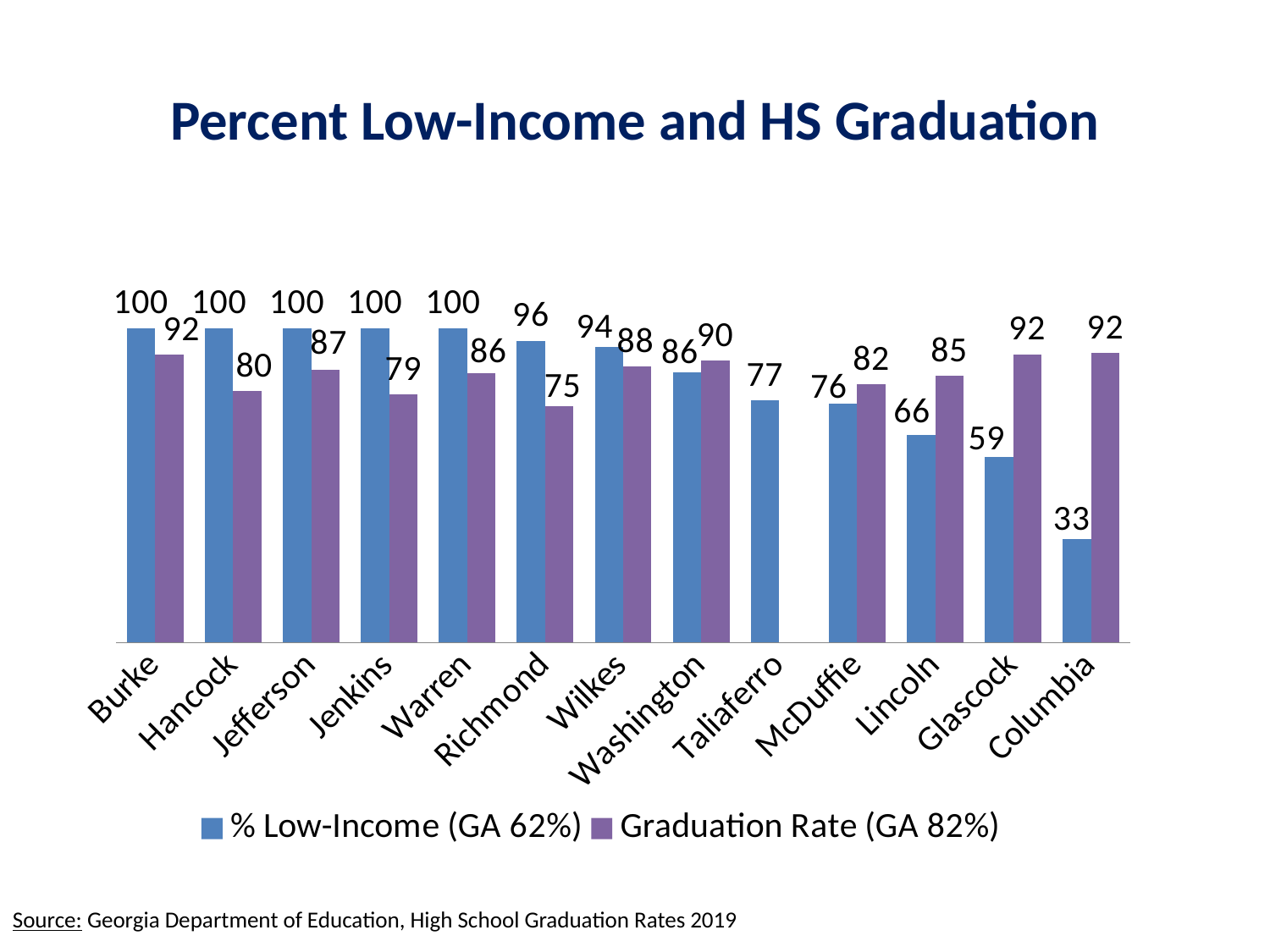
What is the % Low-Income value for Columbia? 33 What is the Graduation Rate for Richmond? 75 What is the Graduation Rate for Washington? 90 Do the % Low-Income values rise or fall moving from Burke to Columbia along the x axis? Fall What is the difference between the % Low-Income and Graduation Rate values for Hancock? 20 Which is larger for Lincoln: the % Low-Income value or the Graduation Rate? Graduation Rate Which county has the lowest Graduation Rate? Richmond How many counties are shown on the x axis? 13 What is the difference between the Graduation Rate for Glascock and the Graduation Rate for Jenkins? 13 How many series does the legend list? 2 Which county has the lowest % Low-Income value? Columbia What kind of chart is shown on the slide? Bar chart